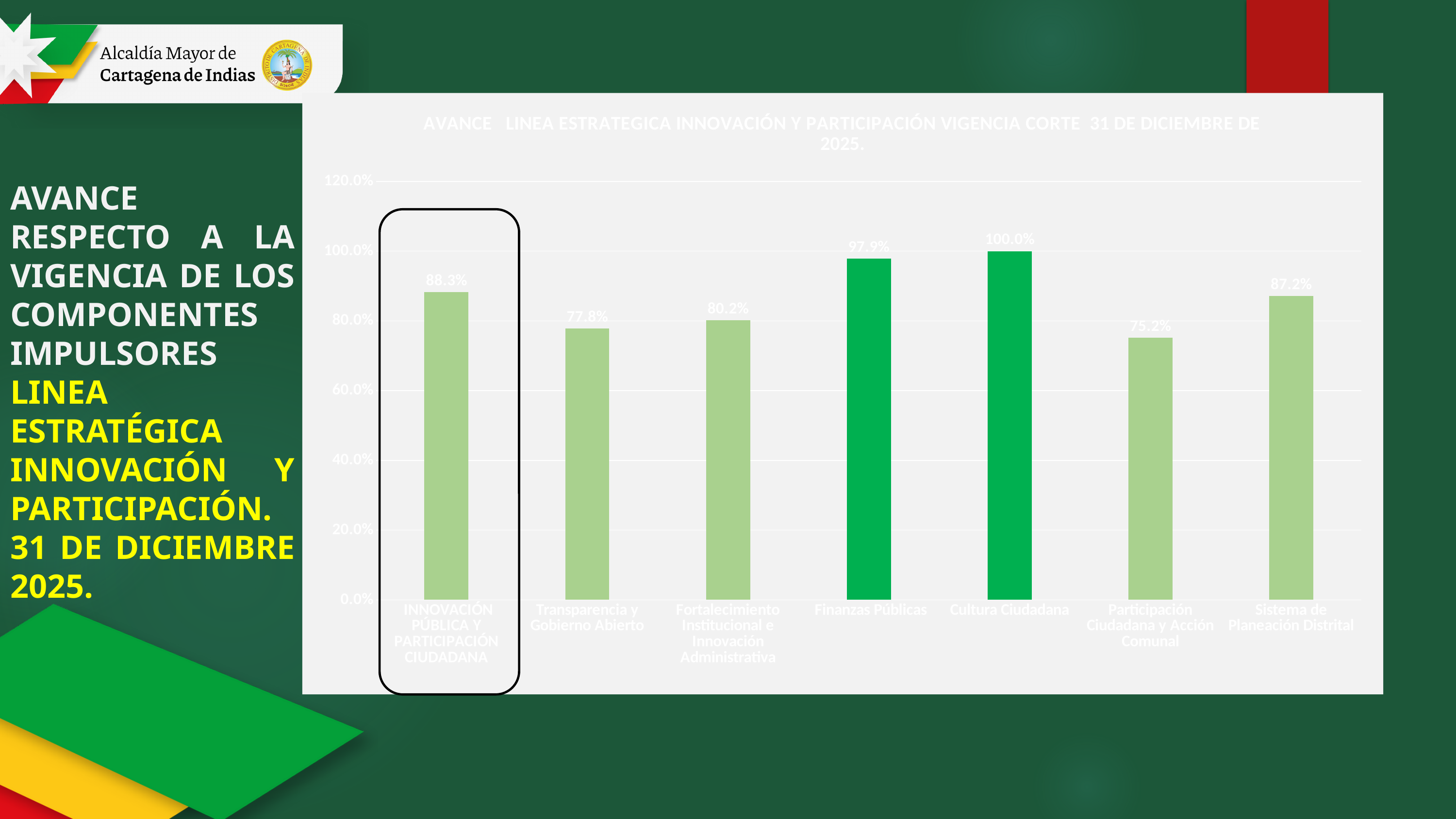
What is the value for Cultura Ciudadana? 100.0% Which category has the lowest value? Participación Ciudadana y Acción Comunal What is the value for Sistema de Planeación Distrital? 87.2% What is the value for Transparencia y Gobierno Abierto? 77.8% Is the value for Finanzas Públicas greater or less than 80.0%? greater Which category has the highest value? Cultura Ciudadana Which category's bar is outlined with a rounded rectangle on the slide? Innovación Pública y Participación Ciudadana What is the difference between the values for Cultura Ciudadana and Participación Ciudadana y Acción Comunal? 24.8% Which is larger, the value for Innovación Pública y Participación Ciudadana or the value for Fortalecimiento Institucional e Innovación Administrativa? Innovación Pública y Participación Ciudadana What type of chart is shown on the slide? Bar chart How many categories are plotted in the chart? 7 What is the value for Finanzas Públicas? 97.9%